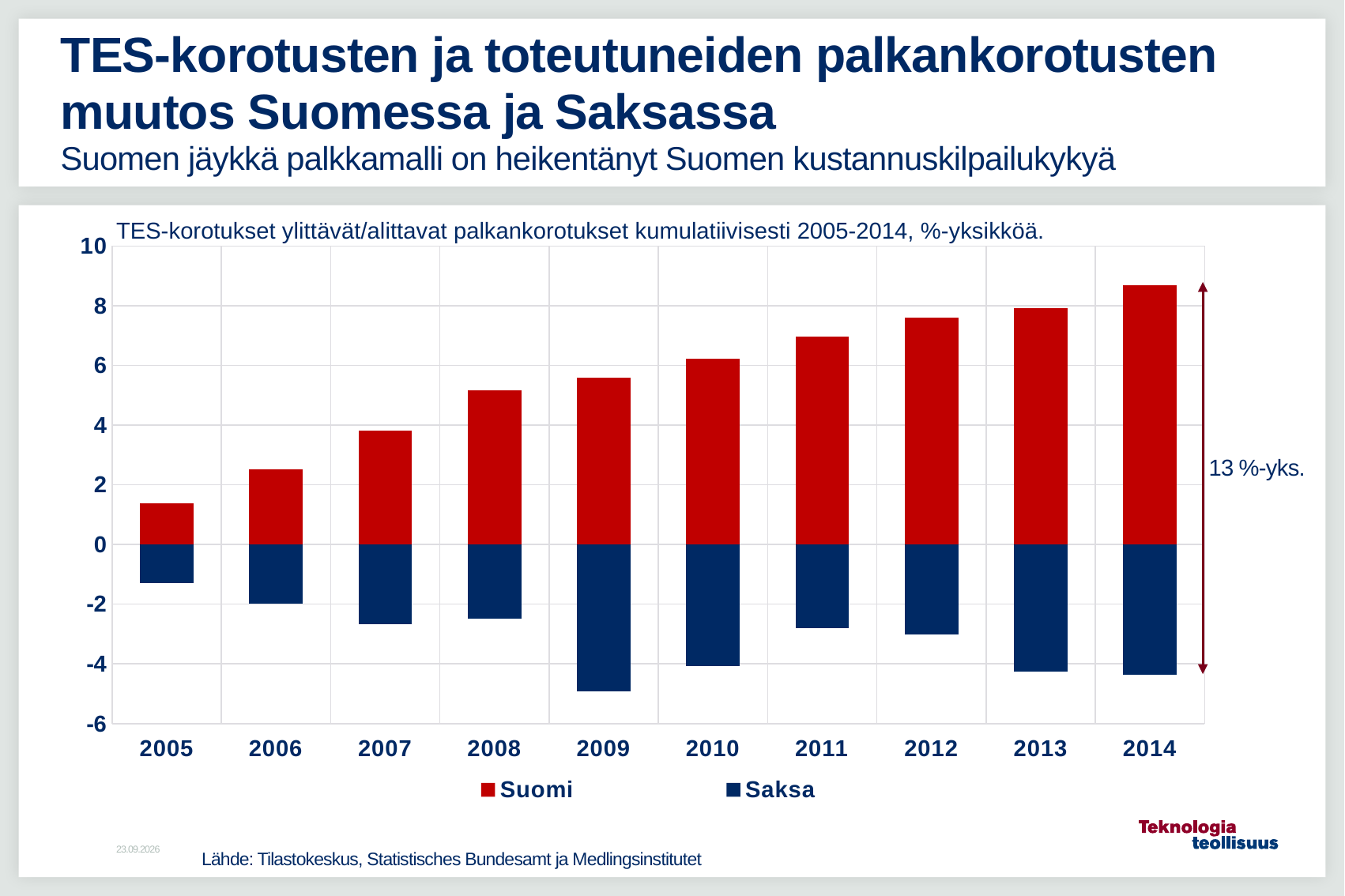
In which year is the Suomi value highest? 2014 Is the Suomi value for 2010 greater or less than 6? greater Is the Suomi value for 2014 greater or less than 8? greater How many series does the chart legend list? 2 In which year does the Saksa bar extend furthest below zero? 2009 In which year is the Suomi value lowest? 2005 Do the Suomi values rise or fall from 2005 to 2014? rise Is the Suomi value for 2005 greater or less than 2? less How many years are shown on the x axis of the chart? 10 What value does the annotation with the arrow on the right side of the chart show? 13 %-yks. What kind of chart is shown on the slide? bar chart